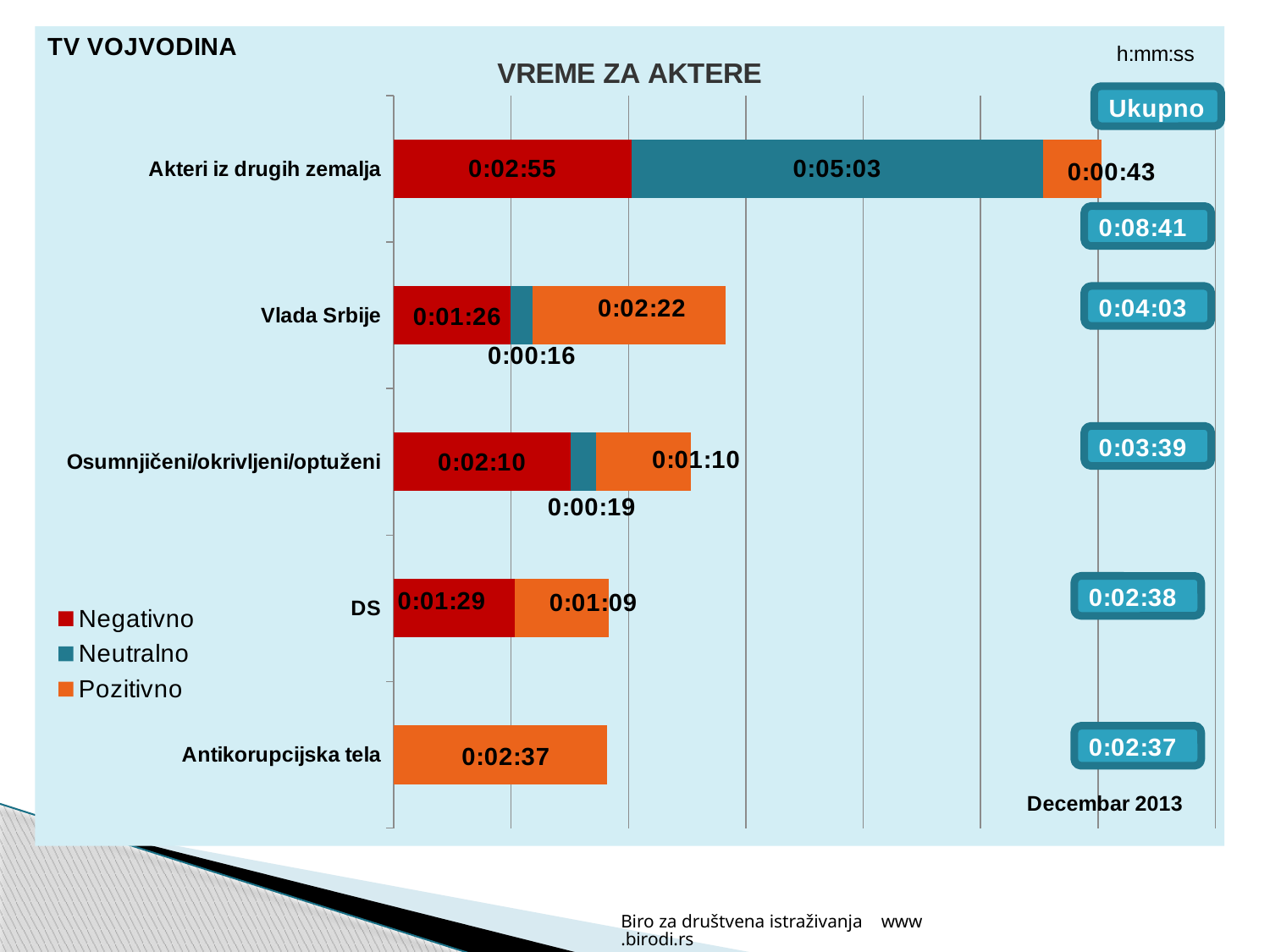
What is the total (Ukupno) time for Osumnjičeni/okrivljeni/optuženi? 0:03:39 What is the Negativno value for Osumnjičeni/okrivljeni/optuženi? 0:02:10 What is the Pozitivno value for Vlada Srbije? 0:02:22 How many series does the legend list? 3 What is the title of the chart? VREME ZA AKTERE Which is larger for DS: the Negativno value or the Pozitivno value? Negativno What kind of chart is shown on the slide? stacked bar chart How many categories (actors) are plotted on the chart? 5 What is the difference between the Negativno and Pozitivno values for DS? 0:00:20 What is the Pozitivno value for Antikorupcijska tela? 0:02:37 Which category has the highest total (Ukupno) time? Akteri iz drugih zemalja What is the Neutralno value for Akteri iz drugih zemalja? 0:05:03